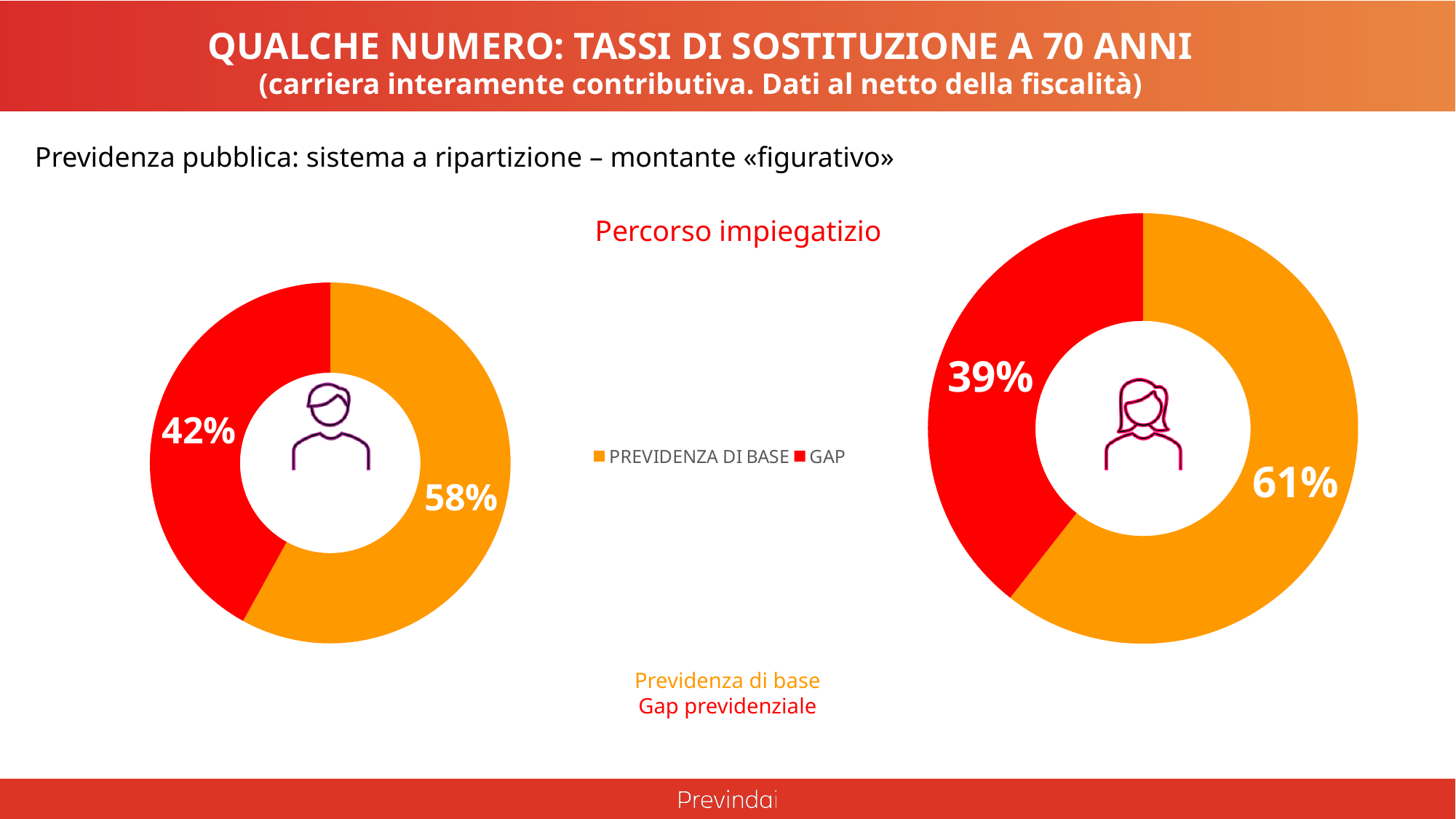
In the left doughnut chart, which slice is the largest? PREVIDENZA DI BASE In the left doughnut chart, what is the difference between PREVIDENZA DI BASE and GAP? 16% In the left doughnut chart (with the male icon), what is the value for PREVIDENZA DI BASE? 58% In the right doughnut chart, which slice is the smallest? GAP Which colour represents GAP in the legend? Red In the right doughnut chart, what is the difference between PREVIDENZA DI BASE and GAP? 22% What kind of chart is used on this slide? Doughnut chart How many series does the legend list? 2 In the right doughnut chart (with the female icon), what is the value for PREVIDENZA DI BASE? 61% In the left doughnut chart (with the male icon), what is the value for GAP? 42% Is the GAP value larger in the left doughnut chart or in the right doughnut chart? Left In the right doughnut chart (with the female icon), what is the value for GAP? 39%